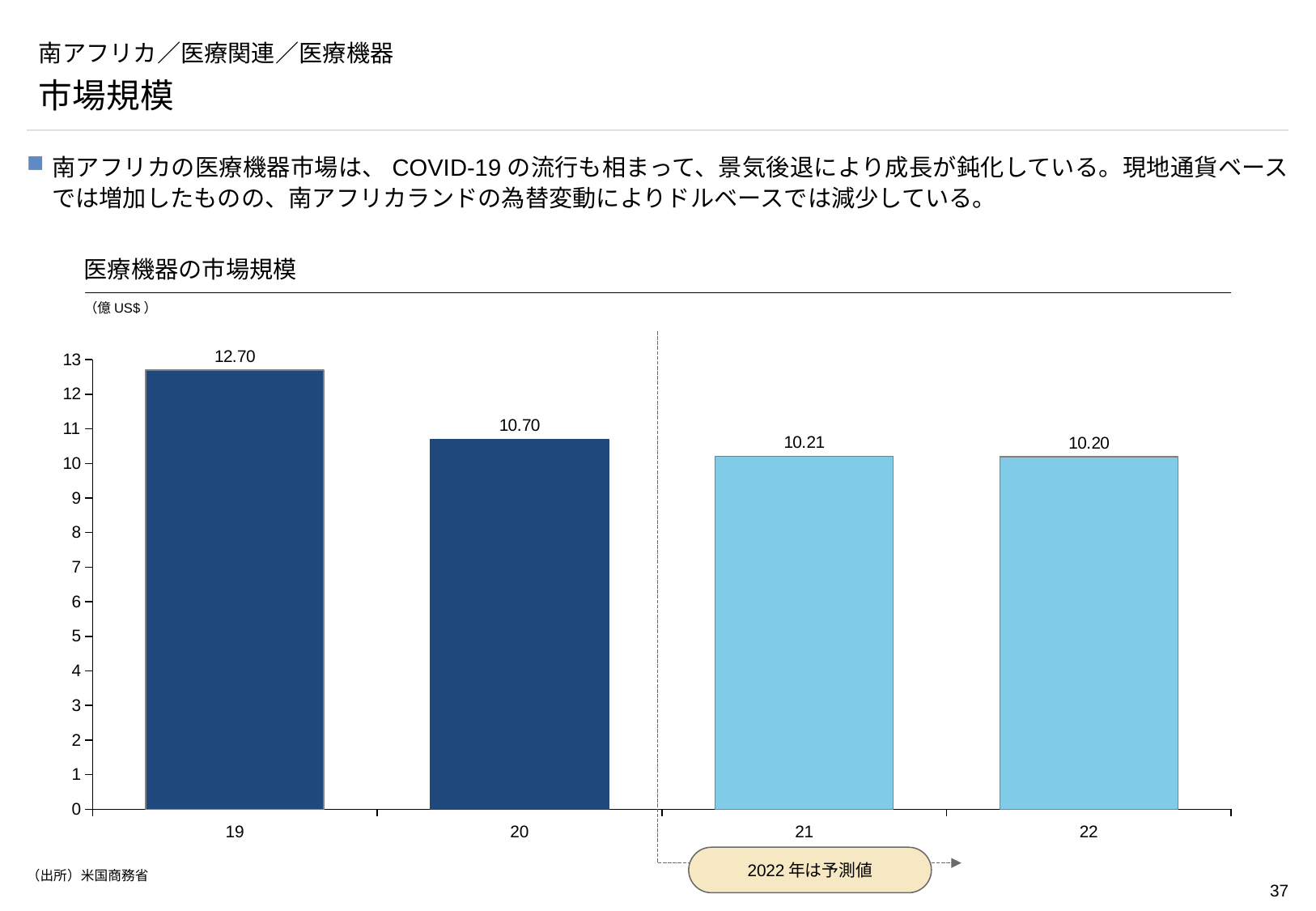
How many years are shown on the x axis? 4 What is the difference between the values for 19 and 20? 2.00 What is the difference between the values for 20 and 21? 0.49 What is the market size value for 20? 10.70 Do the values rise or fall from 19 to 22? fall What is the market size value for 19? 12.70 Which year has the highest market size? 19 What is the market size value for 22? 10.20 Is the value for 20 greater or less than 11? less What kind of chart is shown on the slide? bar chart What is the market size value for 21? 10.21 Which is larger, the value for 19 or the value for 21? 19